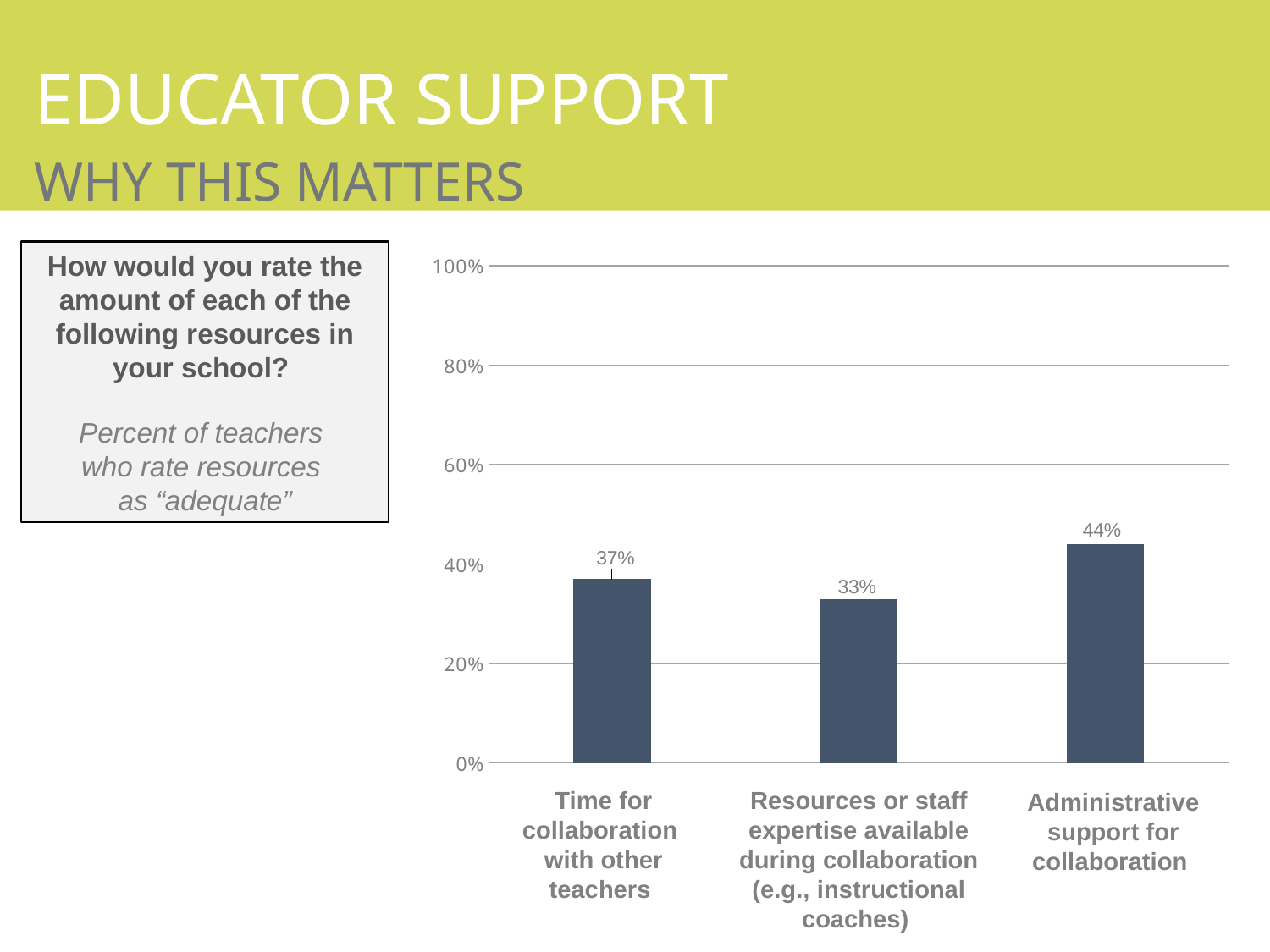
How many categories are shown on the chart? 3 What is the difference in percentage points between 'Administrative support for collaboration' and 'Time for collaboration with other teachers'? 7 percentage points What percent of teachers rate 'Resources or staff expertise available during collaboration (e.g., instructional coaches)' as adequate? 33% What percent of teachers rate 'Time for collaboration with other teachers' as adequate? 37% What kind of chart is shown on the slide? Bar chart Is the value for 'Administrative support for collaboration' greater or less than 40%? greater What is the maximum value shown on the chart's vertical axis? 100% What is the difference in percentage points between 'Time for collaboration with other teachers' and 'Resources or staff expertise available during collaboration'? 4 percentage points What percent of teachers rate 'Administrative support for collaboration' as adequate? 44% Which resource has the highest percent of teachers rating it as adequate? Administrative support for collaboration Which resource has the lowest percent of teachers rating it as adequate? Resources or staff expertise available during collaboration (e.g., instructional coaches) Which is larger: the value for 'Time for collaboration with other teachers' or for 'Resources or staff expertise available during collaboration'? Time for collaboration with other teachers